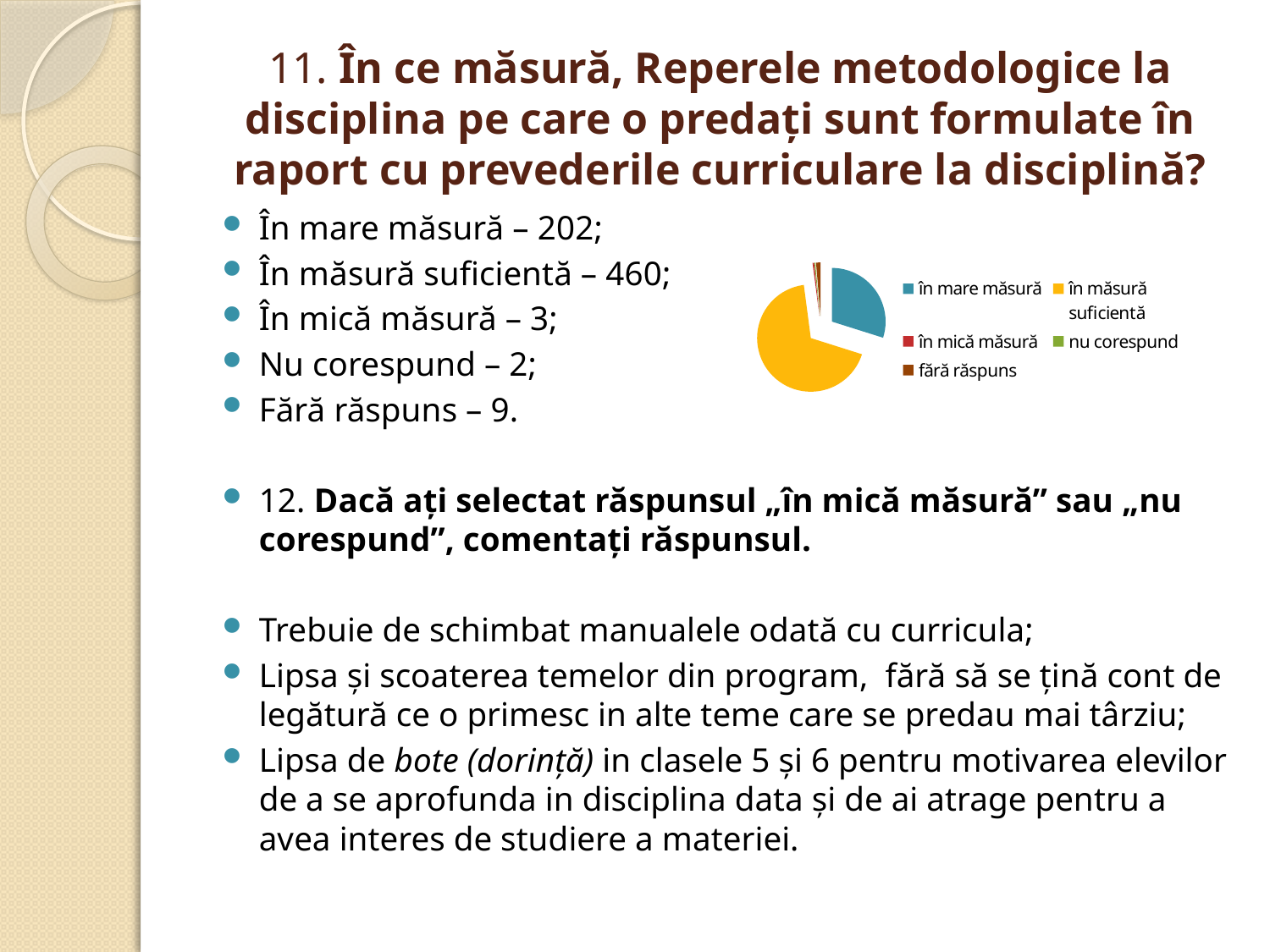
Which category has the largest slice in the pie chart? în măsură suficientă What is the difference between the number of 'În măsură suficientă' responses and 'În mare măsură' responses? 258 What kind of chart is shown on the slide? pie chart According to the slide, how many responses were 'În mare măsură'? 202 According to the slide, how many responses were 'În măsură suficientă'? 460 According to the slide, how many responses were 'Fără răspuns'? 9 How many categories does the legend of the pie chart list? 5 Which is larger in the pie chart: 'în mare măsură' or 'în măsură suficientă'? în măsură suficientă What colour is the 'în măsură suficientă' slice in the pie chart? yellow What colour is the 'în mare măsură' slice in the pie chart? teal According to the slide, how many responses were 'Nu corespund'? 2 What is the total number of responses across all five categories listed on the slide? 676